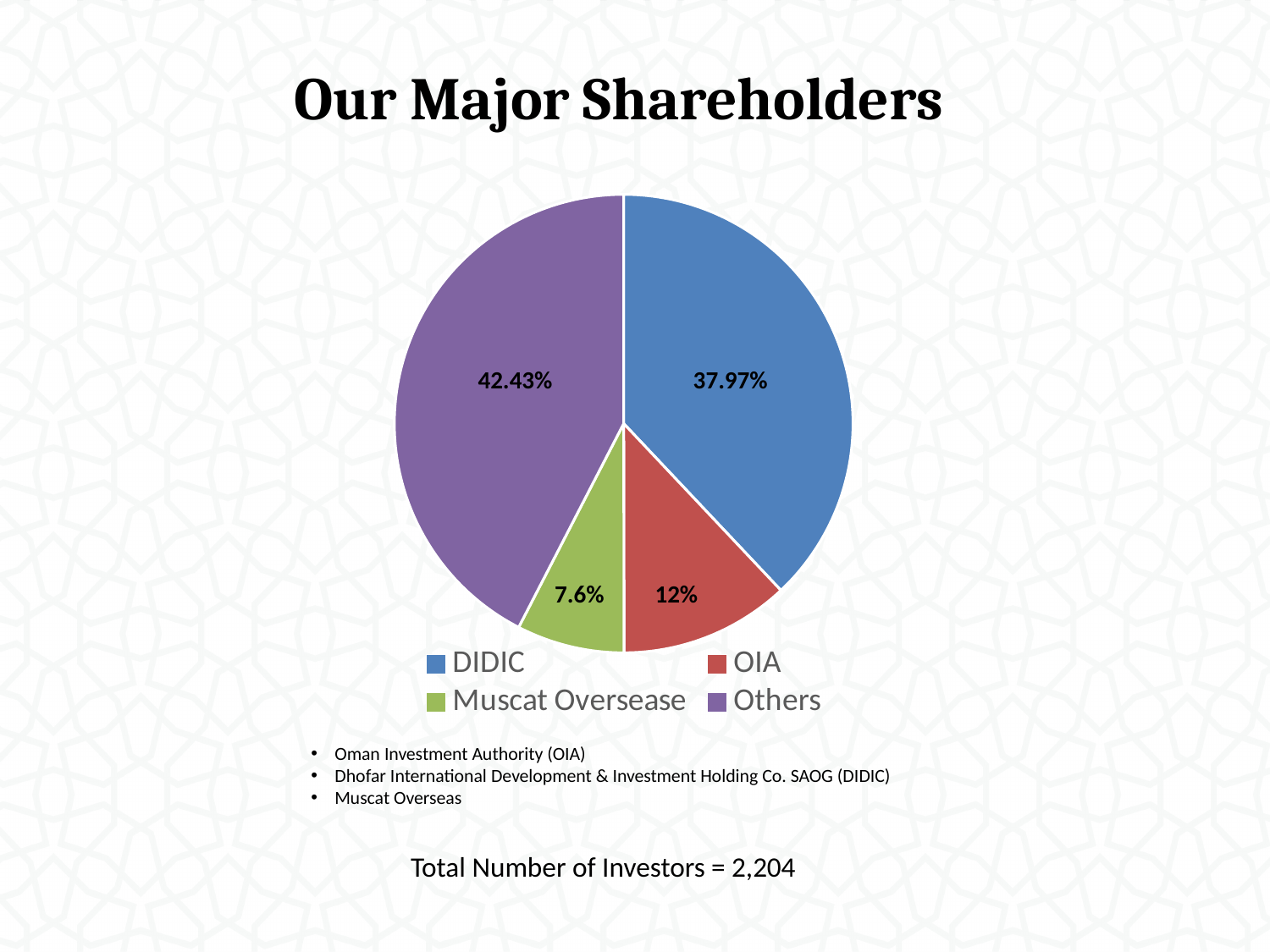
What is the difference between the OIA share and the Muscat Oversease share? 4.4% How many slices does the pie chart have? 4 What share of the pie does OIA hold? 12% What share of the pie does DIDIC hold? 37.97% What kind of chart is shown on the slide? Pie chart What is the difference between the Others share and the DIDIC share? 4.46% What is the title of the slide containing the chart? Our Major Shareholders Which is larger, the DIDIC share or the OIA share? DIDIC What share of the pie does Others hold? 42.43% What share of the pie does Muscat Oversease hold? 7.6% Which slice of the pie is the smallest? Muscat Oversease Which slice of the pie is the largest? Others